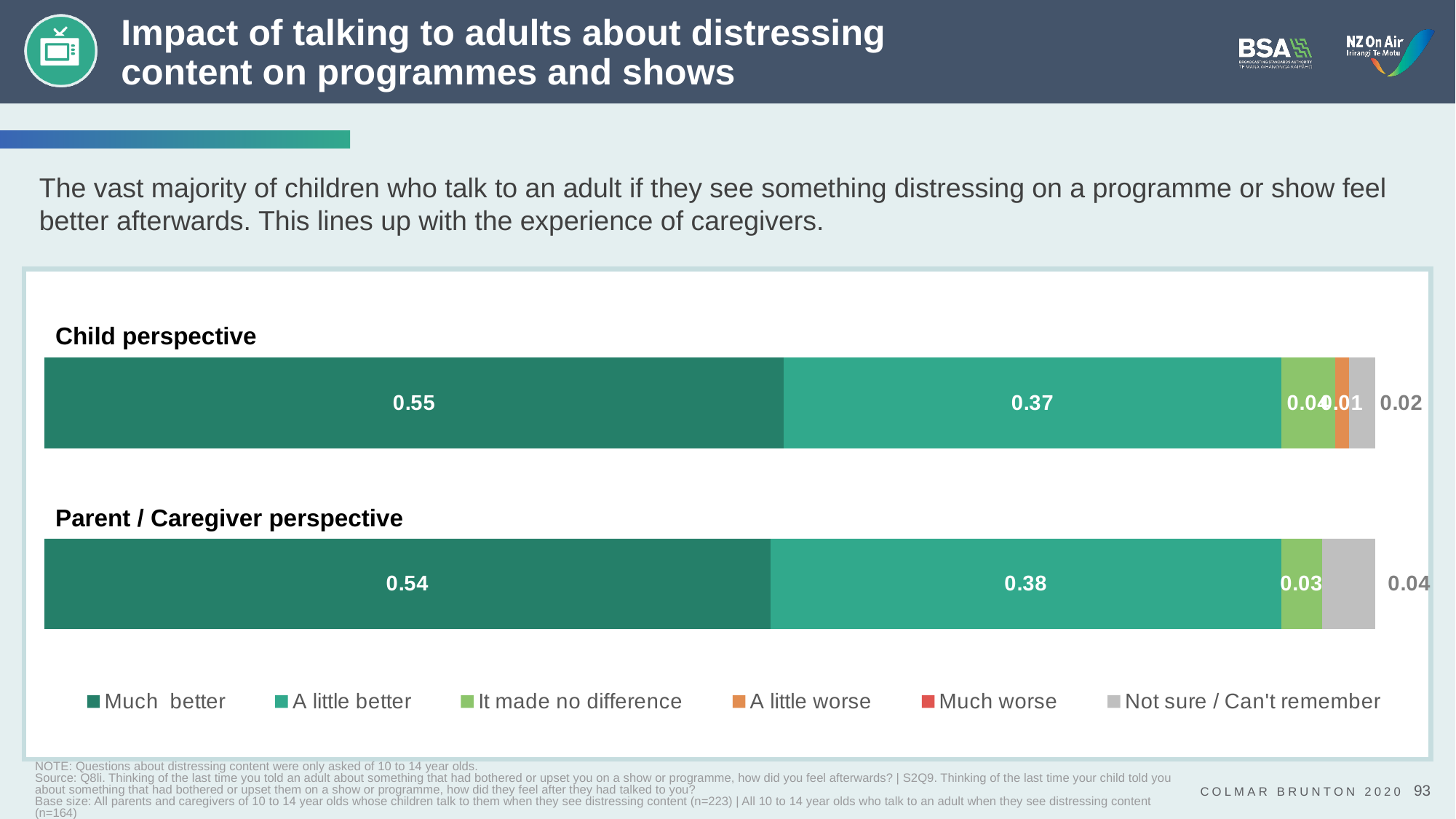
How many series does the legend list? 6 What is the value for 'A little better' in the Child perspective bar? 0.37 What is the value for 'Not sure / Can't remember' in the Child perspective bar? 0.02 What kind of chart is shown on the slide? Stacked bar chart Which has the larger 'Much better' value, the Child perspective or the Parent / Caregiver perspective? Child perspective What is the value for 'Not sure / Can't remember' in the Parent / Caregiver perspective bar? 0.04 What is the value for 'A little better' in the Parent / Caregiver perspective bar? 0.38 What is the difference between the 'A little better' values for the Parent / Caregiver perspective and the Child perspective? 0.01 How many bars (perspectives) are shown in the chart? 2 What is the value for 'It made no difference' in the Parent / Caregiver perspective bar? 0.03 What is the value for 'Much better' in the Child perspective bar? 0.55 Which response has the largest share in the Parent / Caregiver perspective bar? Much better